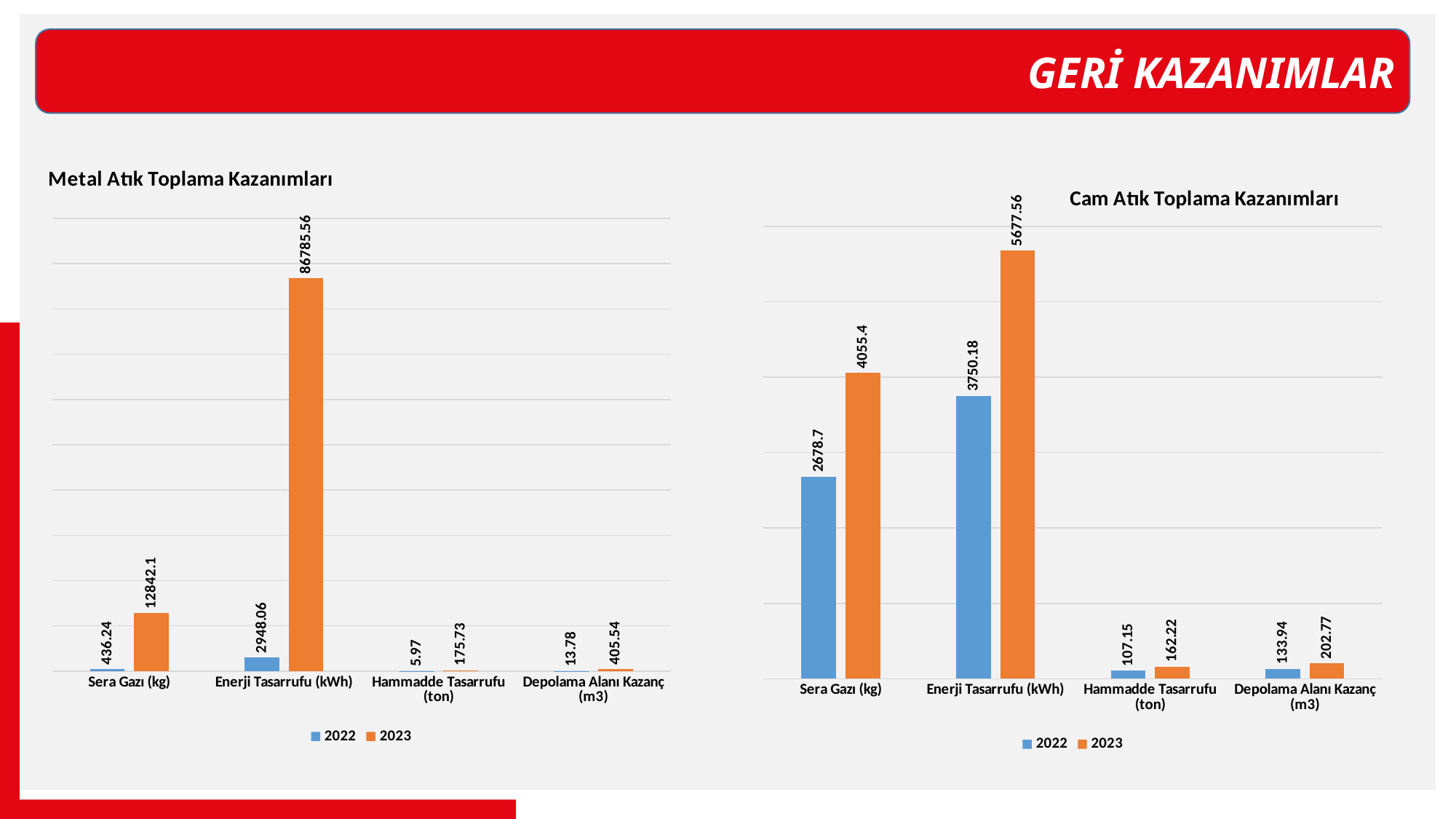
In the Cam Atık Toplama Kazanımları chart, which is larger: the 2022 value for Sera Gazı (kg) or the 2022 value for Enerji Tasarrufu (kWh)? Enerji Tasarrufu (kWh) In the Metal Atık Toplama Kazanımları chart, which category has the lowest 2022 value? Hammadde Tasarrufu (ton) In the Cam Atık Toplama Kazanımları chart, what is the difference between the 2023 and 2022 values for Enerji Tasarrufu (kWh)? 1927.38 In the Metal Atık Toplama Kazanımları chart, which category has the highest 2023 value? Enerji Tasarrufu (kWh) In the Cam Atık Toplama Kazanımları chart, what is the 2022 value for Depolama Alanı Kazanç (m3)? 133.94 In the Metal Atık Toplama Kazanımları chart, what is the 2023 value for Enerji Tasarrufu (kWh)? 86785.56 How many series does the legend of the Cam Atık Toplama Kazanımları chart list? 2 What type of chart is the Cam Atık Toplama Kazanımları chart? Bar chart In the Metal Atık Toplama Kazanımları chart, what is the 2022 value for Sera Gazı (kg)? 436.24 How many categories are shown on the x axis of the Metal Atık Toplama Kazanımları chart? 4 In the Cam Atık Toplama Kazanımları chart, what is the difference between the 2023 and 2022 values for Sera Gazı (kg)? 1376.7 In the Cam Atık Toplama Kazanımları chart, what is the 2023 value for Sera Gazı (kg)? 4055.4